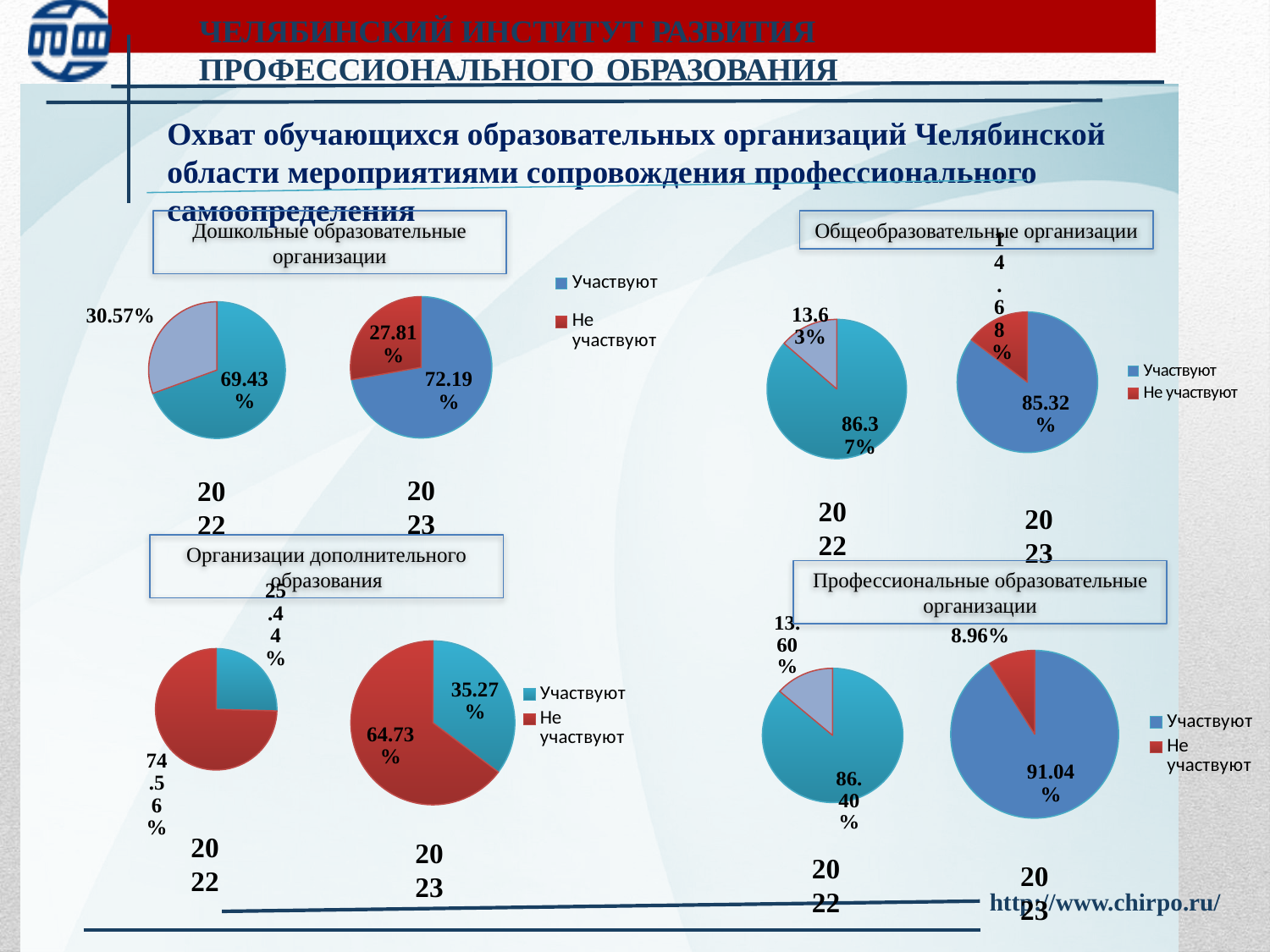
How many entries does the legend list for the Общеобразовательные организации charts? 2 In the 2022 pie chart for Дошкольные образовательные организации, what share is labelled for the smaller slice? 30.57% For Дошкольные образовательные организации, by how many percentage points did the Участвуют share change from 2022 (69.43%) to 2023 (72.19%)? 2.76 What type of charts are shown on the slide? Pie charts In the 2023 pie chart for Общеобразовательные организации, what share is labelled for the Участвуют slice? 85.32% How many pie charts are shown on the slide in total? 8 In the 2023 pie chart for Организации дополнительного образования, what share is labelled for the Не участвуют slice? 64.73% In the 2023 pie chart for Дошкольные образовательные организации, what share is labelled for the Участвуют slice? 72.19% In the 2023 pie chart for Организации дополнительного образования, which slice is larger, Участвуют or Не участвуют? Не участвуют In the 2023 pie chart for Профессиональные образовательные организации, what share is labelled for the Участвуют slice? 91.04% In the 2022 pie chart for Профессиональные образовательные организации, what share is labelled for the larger slice? 86.40% For Профессиональные образовательные организации, which year has the larger Участвуют share, 2022 or 2023? 2023